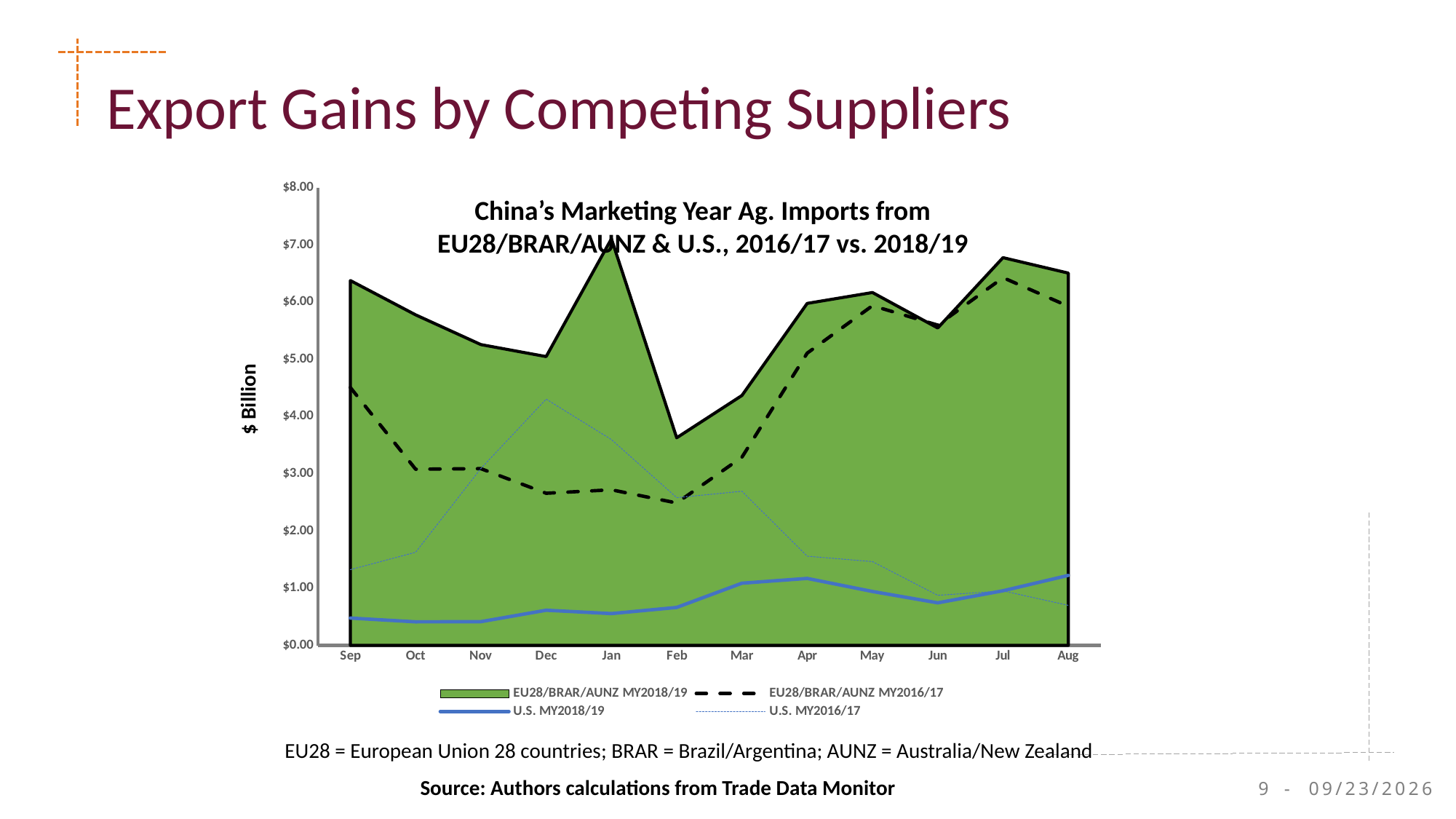
How many months are shown along the x axis of the chart? 12 Does the U.S. MY2016/17 series rise or fall from Dec to Aug? fall In Dec, which is larger: the U.S. MY2016/17 value or the EU28/BRAR/AUNZ MY2016/17 value? U.S. MY2016/17 Is the EU28/BRAR/AUNZ MY2018/19 value for Feb greater or less than $4.00? less In which month is the EU28/BRAR/AUNZ MY2018/19 value highest? Jan Is the U.S. MY2016/17 value for Dec greater or less than $4.00? greater What is the label on the vertical axis of the chart? $ Billion In which month is the EU28/BRAR/AUNZ MY2018/19 value lowest? Feb In which month does the U.S. MY2016/17 series reach its highest value? Dec Is the EU28/BRAR/AUNZ MY2016/17 value for Feb greater or less than $3.00? less How many series does the chart legend list? 4